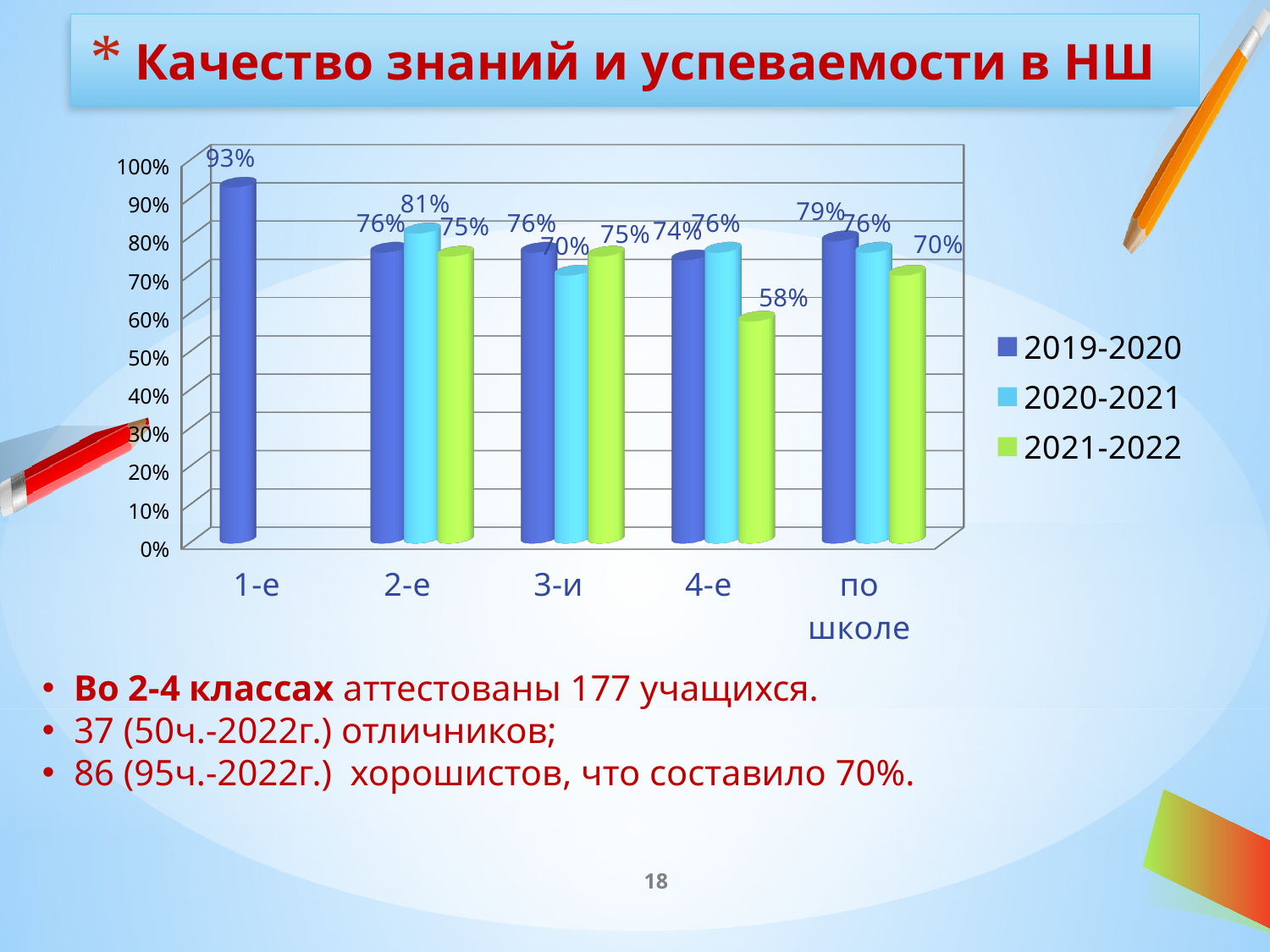
Do the values for по школе rise or fall from 2019-2020 to 2021-2022? fall How many categories are shown on the x axis? 5 How many series does the legend list? 3 What is the value for 4-е in the 2021-2022 series? 58% Which category has the lowest value in the 2021-2022 series? 4-е What kind of chart is shown on the slide? bar chart What is the value for 1-е in the 2019-2020 series? 93% Which category has the highest value in the 2019-2020 series? 1-е What is the value for 2-е in the 2020-2021 series? 81% What is the difference between the 2020-2021 and 2021-2022 values for 4-е? 18% What is the value for по школе in the 2019-2020 series? 79% Which is larger for 3-и: the 2019-2020 value or the 2020-2021 value? 2019-2020